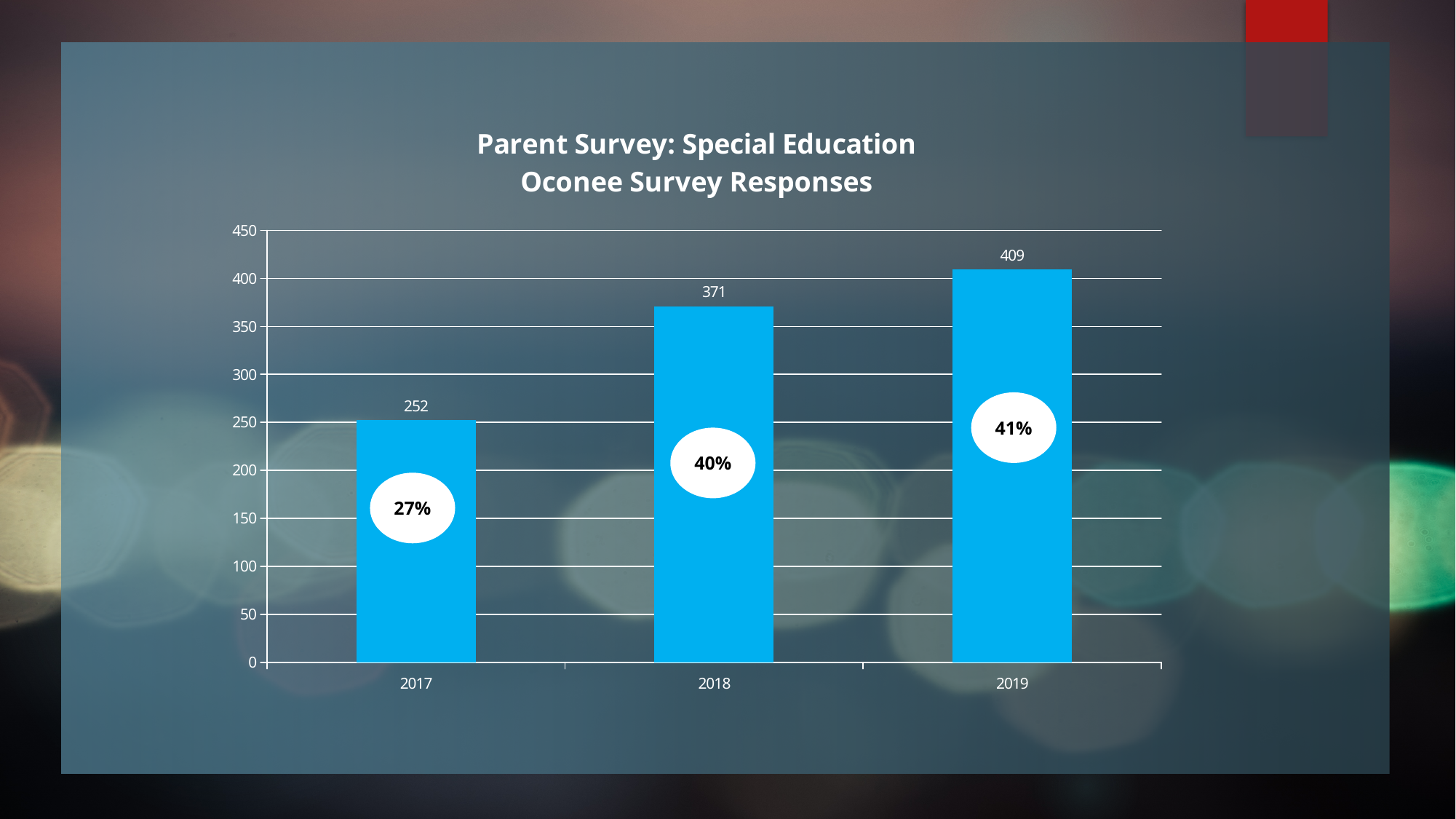
What is the difference in survey responses between 2018 and 2017? 119 What percentage is shown in the circle on the 2017 bar? 27% What kind of chart is shown on the slide? Bar chart What is the number of survey responses for 2017? 252 What is the number of survey responses for 2018? 371 What is the difference in survey responses between 2019 and 2017? 157 What is the number of survey responses for 2019? 409 Which year had more survey responses, 2017 or 2018? 2018 Which year has the lowest number of survey responses? 2017 Which year has the highest number of survey responses? 2019 Is the value for 2019 greater or less than 400? greater How many years are shown on the x axis? 3